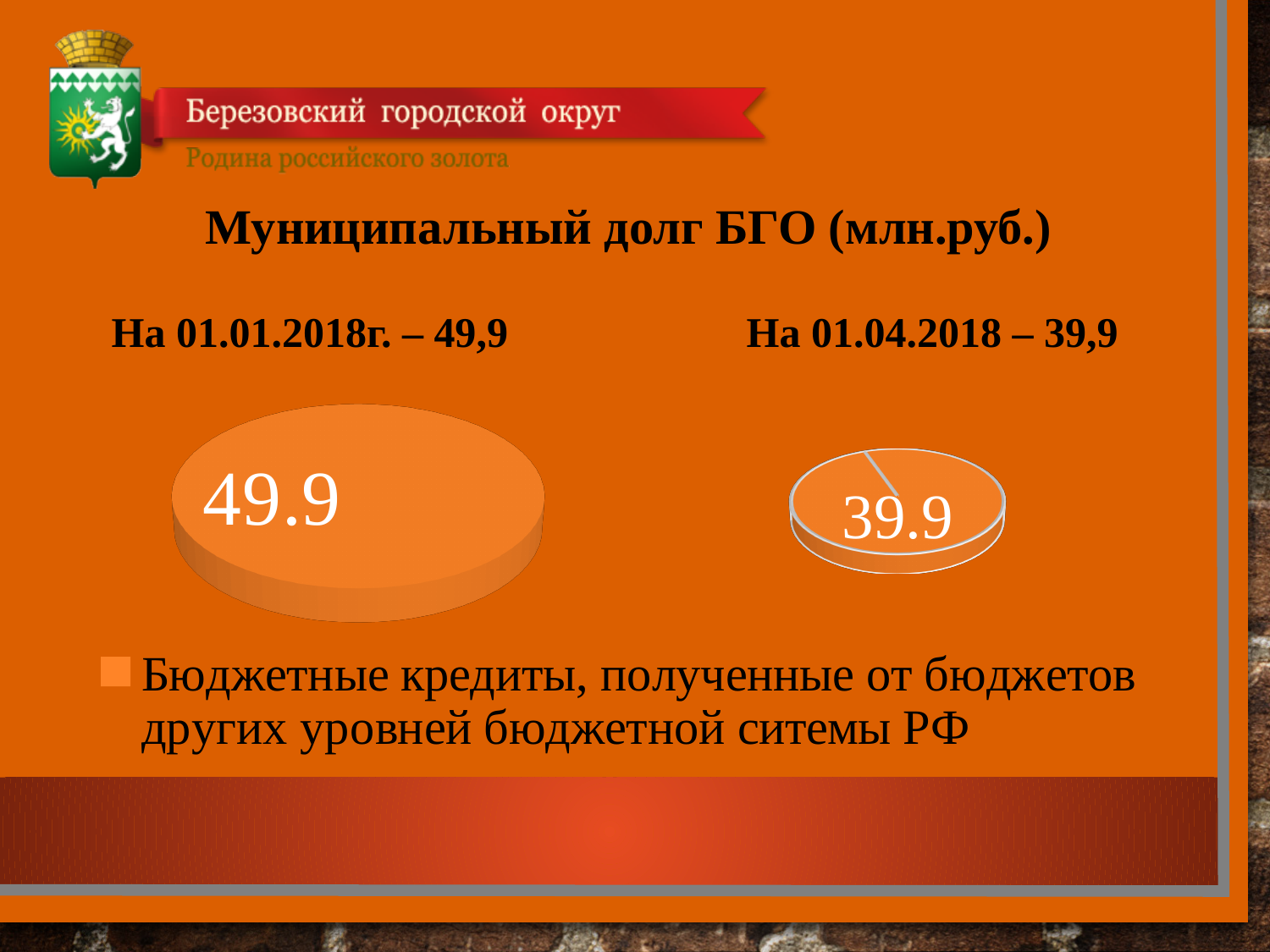
How many entries does the legend below the charts list? 1 Which pie chart shows the larger value, the left one (01.01.2018) or the right one (01.04.2018)? The left one (01.01.2018) What value is shown on the left pie chart (as of 01.01.2018)? 49.9 What is the title above the two pie charts? Муниципальный долг БГО (млн.руб.) Did the municipal debt rise or fall from 01.01.2018 to 01.04.2018? Fall What is the legend entry shown below the pie charts? Бюджетные кредиты, полученные от бюджетов других уровней бюджетной ситемы РФ What share of the left pie chart (01.01.2018) does its single slice occupy? 100% By how much does the value on the left pie chart (49.9) exceed the value on the right pie chart (39.9)? 10 How many slices does the left pie chart (01.01.2018) contain? 1 What value is shown on the right pie chart (as of 01.04.2018)? 39.9 What kind of chart is used to show the municipal debt on this slide? Pie chart